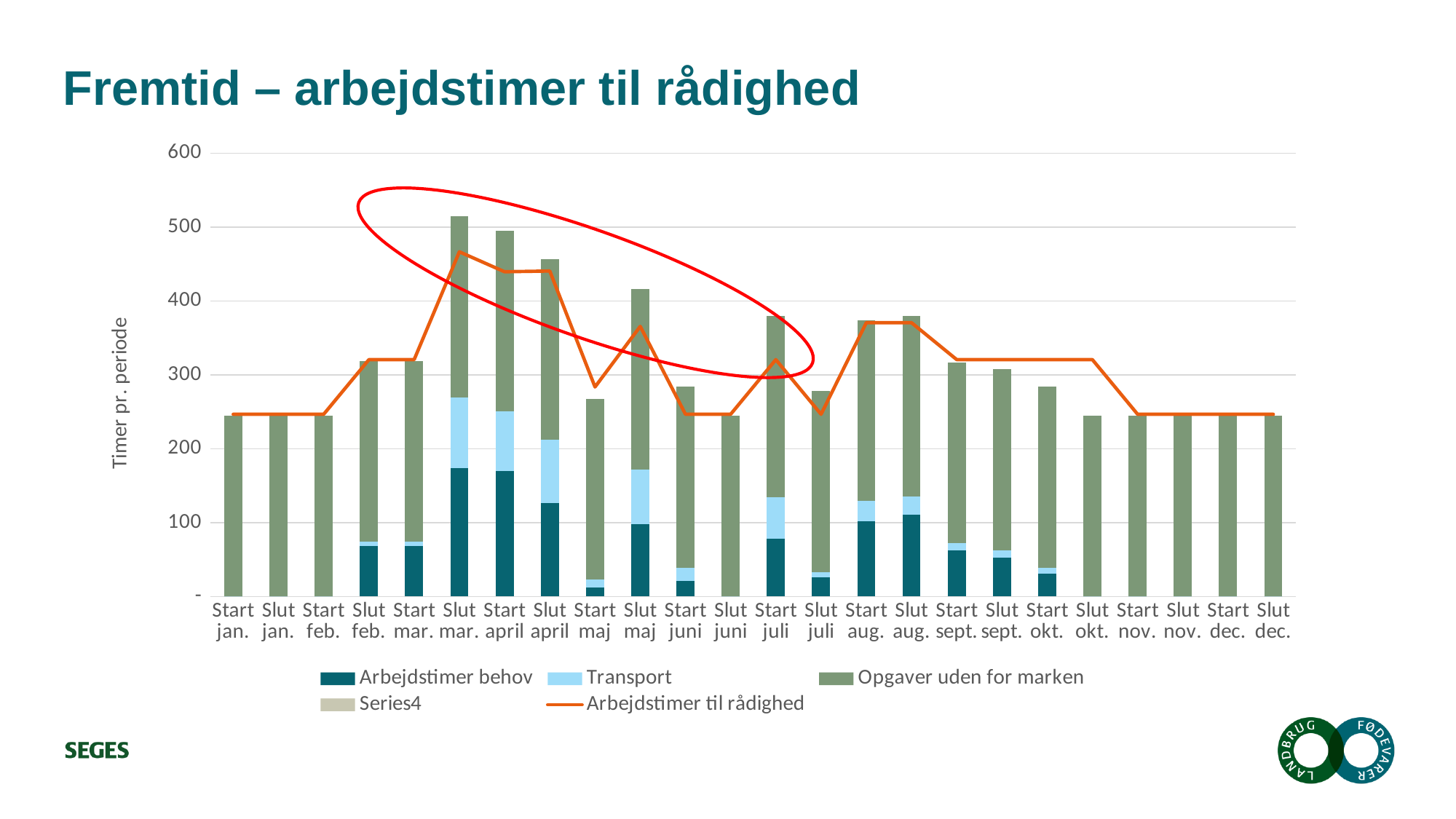
What is the title of the chart on the slide? Fremtid – arbejdstimer til rådighed Is the total stacked bar for Start maj greater or less than 300? less What kind of chart is shown on the slide? A stacked bar chart with a line How many categories are shown along the x axis? 24 Is the Arbejdstimer til rådighed line value at Start jan. greater or less than 300? less Is the Arbejdstimer til rådighed line value at Slut mar. greater or less than 400? greater Does the Arbejdstimer til rådighed line rise or fall from Slut okt. to Start nov.? fall Which has the taller stacked bar, Start juli or Slut juli? Start juli What is the label on the vertical axis? Timer pr. periode Which category has the tallest stacked bar? Slut mar. How many series does the legend list? 5